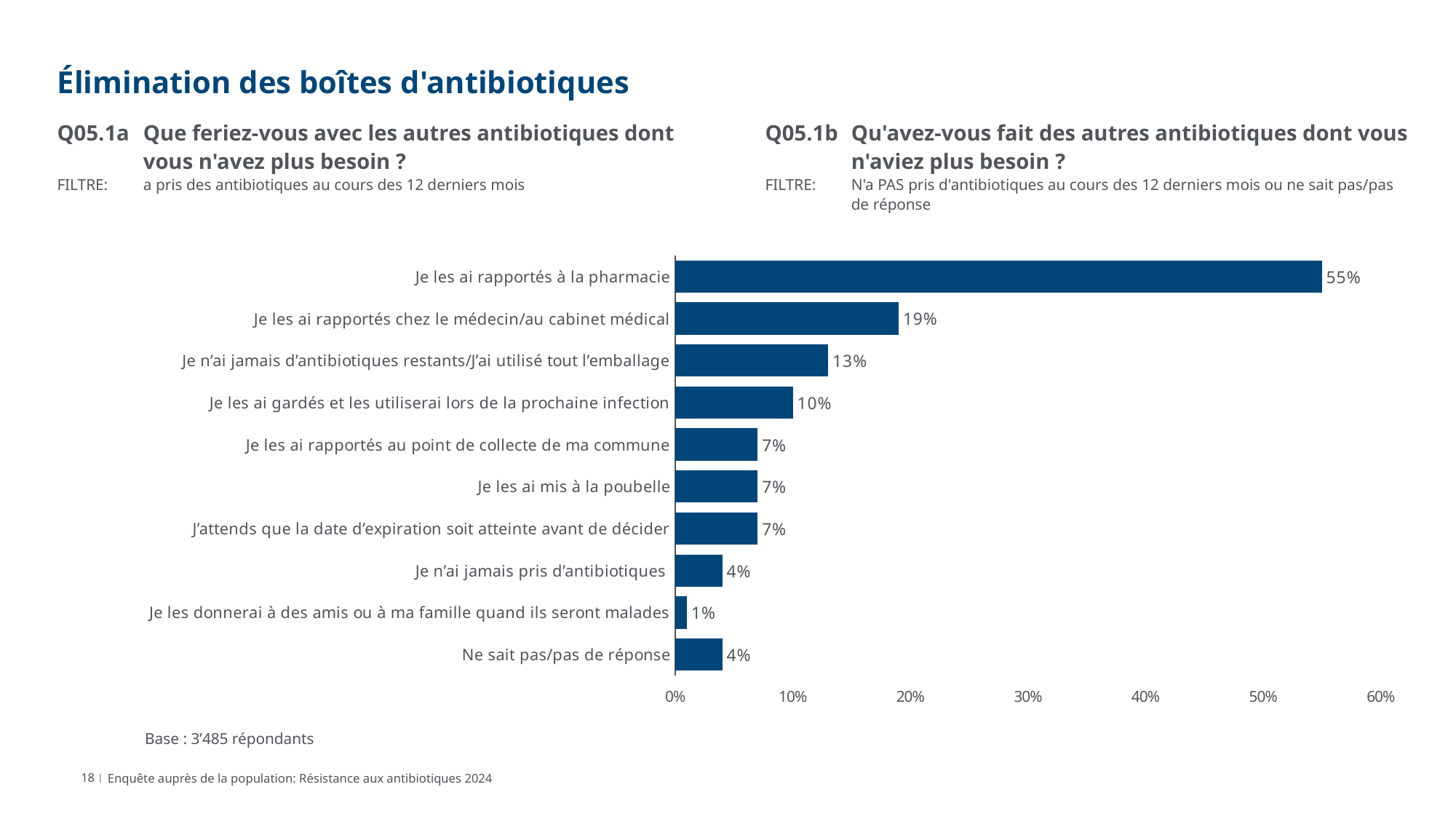
Is the value for "Je les ai rapportés à la pharmacie" greater or less than 50%? greater Which is larger: the value for "Je n’ai jamais d’antibiotiques restants/J’ai utilisé tout l’emballage" or for "Je les ai gardés et les utiliserai lors de la prochaine infection"? Je n’ai jamais d’antibiotiques restants/J’ai utilisé tout l’emballage What is the difference between the values for "Je les ai rapportés à la pharmacie" and "Je les ai rapportés chez le médecin/au cabinet médical"? 36 percentage points What is the base (number of respondents) stated below the chart? 3’485 répondants Which category has the highest value in the chart? Je les ai rapportés à la pharmacie What percentage of respondents said they returned the antibiotics to the pharmacy ("Je les ai rapportés à la pharmacie")? 55% What is the value for "Je les donnerai à des amis ou à ma famille quand ils seront malades"? 1% What is the value for "Je les ai gardés et les utiliserai lors de la prochaine infection"? 10% What kind of chart is shown on the slide? Bar chart Which category has the lowest value in the chart? Je les donnerai à des amis ou à ma famille quand ils seront malades How many categories are shown in the chart? 10 What is the value for "Je les ai rapportés chez le médecin/au cabinet médical"? 19%